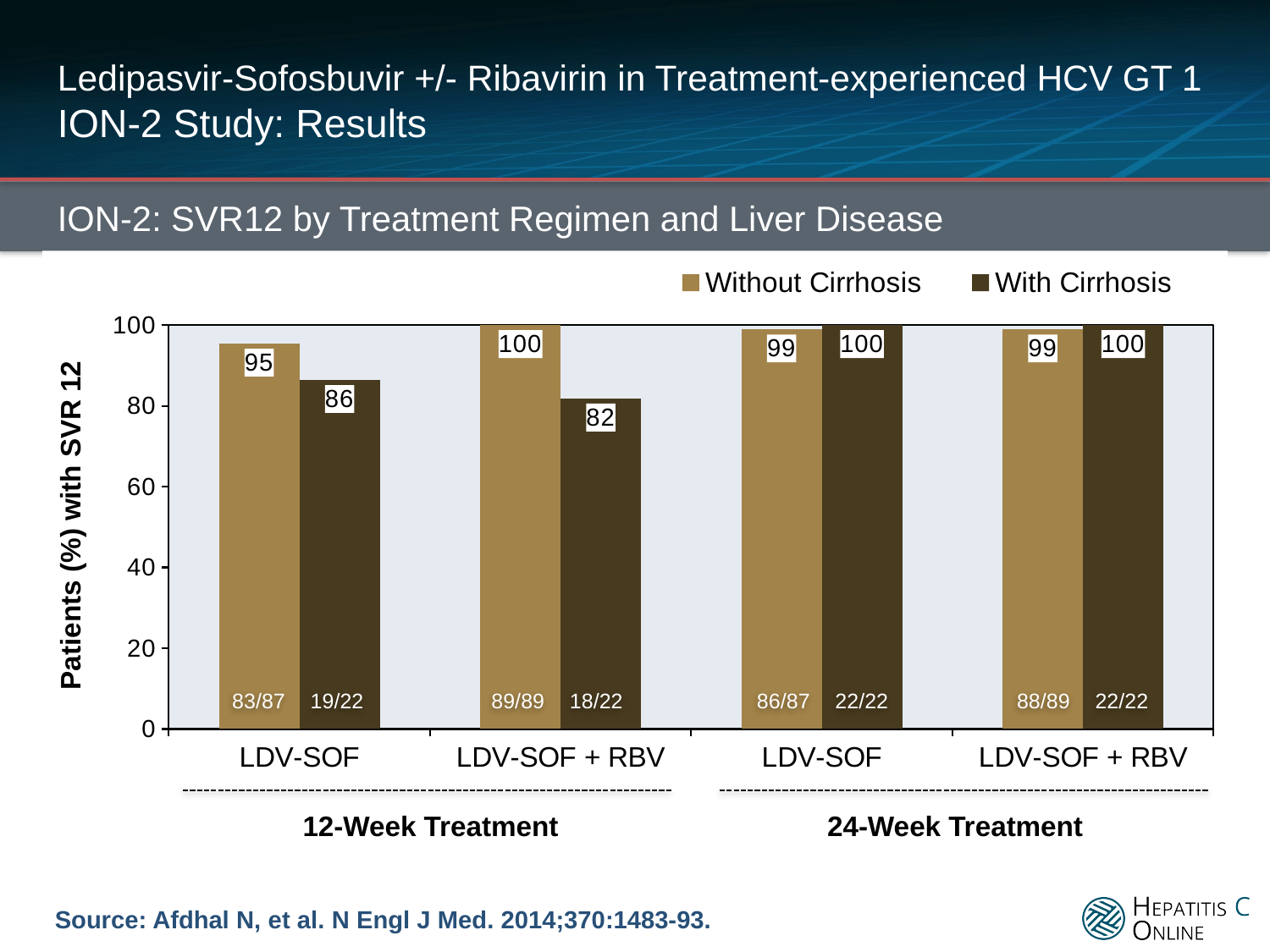
What is the label of the y axis? Patients (%) with SVR 12 What kind of chart is shown on the slide? Bar chart What is the difference in SVR12 rate between patients without cirrhosis and with cirrhosis in the 12-week LDV-SOF group? 9 What is the SVR12 rate for patients with cirrhosis receiving LDV-SOF for 24 weeks? 100 How many series does the legend list? 2 Which treatment group has the lowest SVR12 rate among patients with cirrhosis? LDV-SOF + RBV, 12-Week Treatment What is the SVR12 rate for patients without cirrhosis receiving LDV-SOF + RBV for 24 weeks? 99 What is the difference in SVR12 rate between patients without cirrhosis and with cirrhosis in the 12-week LDV-SOF + RBV group? 18 What is the SVR12 rate for patients without cirrhosis receiving LDV-SOF for 12 weeks? 95 How many treatment regimen categories are shown on the x axis? 4 What is the SVR12 rate for patients with cirrhosis receiving LDV-SOF + RBV for 12 weeks? 82 In the 12-week LDV-SOF group, which has the higher SVR12 rate: patients without cirrhosis or with cirrhosis? Without Cirrhosis